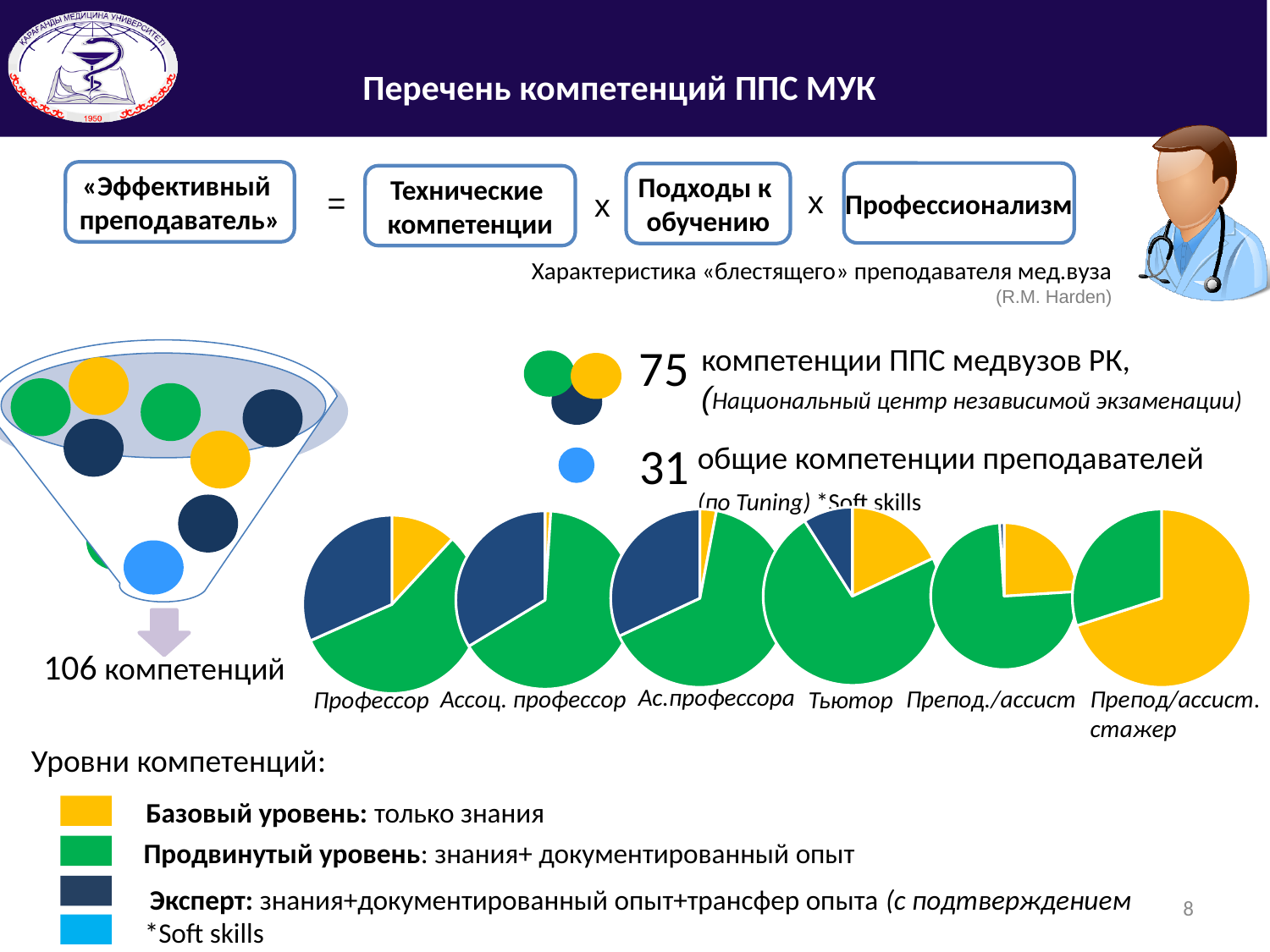
In the Препод/ассист. стажер pie chart, which competency level has the largest slice? Базовый уровень (yellow) What kind of charts are shown in the row above the job-title labels (Профессор, Ассоц. профессор, etc.)? Pie charts According to the legend, which competency level does the dark blue colour represent? Эксперт How many pie charts are shown on the slide? 6 In the Ассоц. профессор pie chart, which competency level has the smallest slice? Базовый уровень (yellow) In the Препод./ассист pie chart, which slice is larger: green (Продвинутый уровень) or yellow (Базовый уровень)? Green (Продвинутый уровень) In the Профессор pie chart, which slice is larger: the dark blue (Эксперт) slice or the yellow (Базовый уровень) slice? Dark blue (Эксперт) According to the legend, which competency level does the yellow colour represent? Базовый уровень: только знания In the Ас.профессора pie chart, which competency level has the largest slice? Продвинутый уровень (green) Which pie chart has the largest share of the yellow (Базовый уровень) slice? Препод/ассист. стажер In the Тьютор pie chart, which competency level has the largest slice? Продвинутый уровень (green)